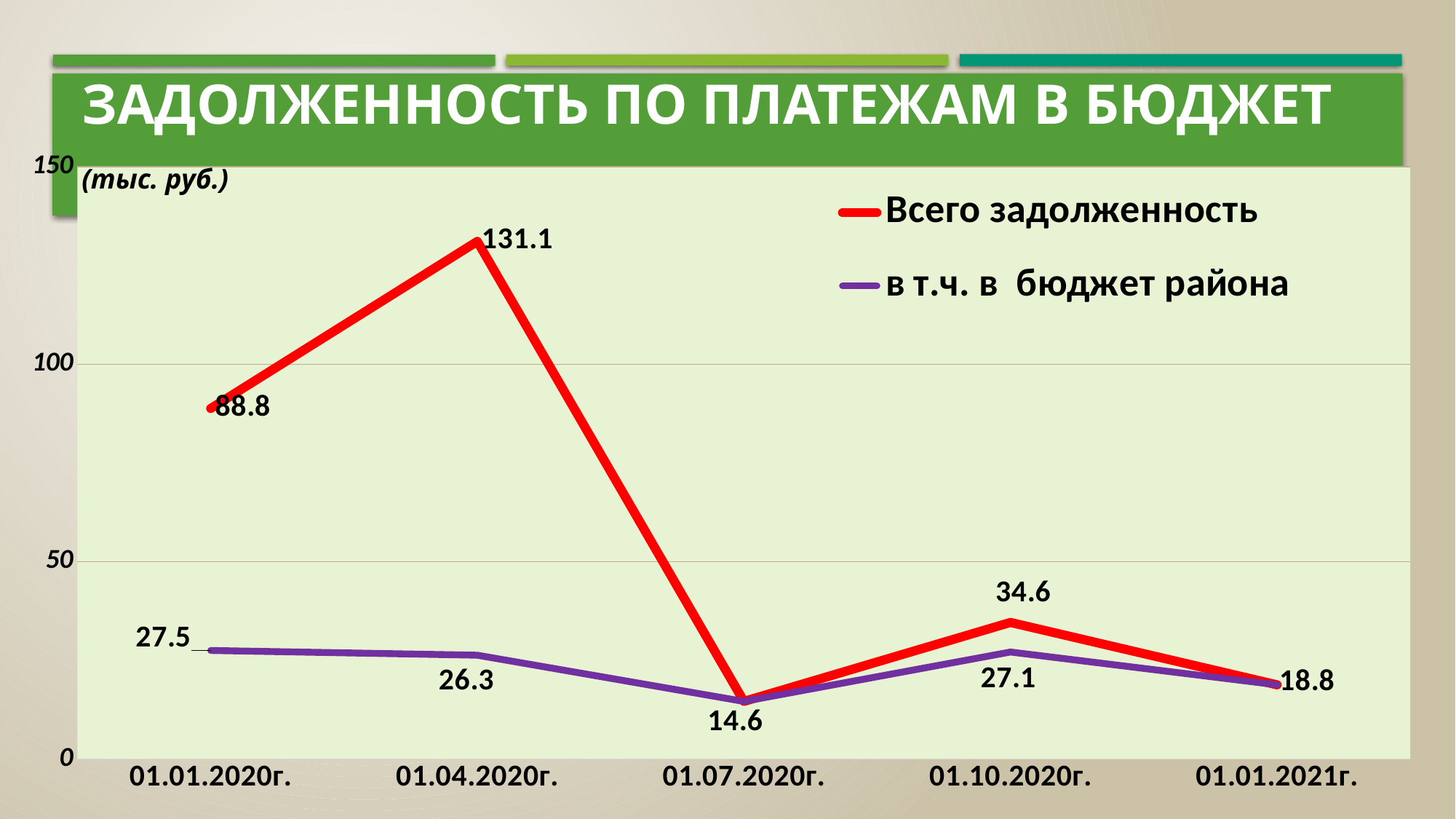
What is the value of «в т.ч. в бюджет района» on 01.10.2020г.? 27.1 How many series does the legend list? 2 What is the value of «Всего задолженность» on 01.10.2020г.? 34.6 What is the difference between «Всего задолженность» and «в т.ч. в бюджет района» on 01.10.2020г.? 7.5 What kind of chart is shown on the slide? line chart What is the value of «в т.ч. в бюджет района» on 01.04.2020г.? 26.3 What is the value of «Всего задолженность» on 01.04.2020г.? 131.1 How many dates are shown on the x axis? 5 Is the value of «Всего задолженность» on 01.04.2020г. greater or less than 100? greater What is the value of «Всего задолженность» on 01.01.2020г.? 88.8 On which date does «Всего задолженность» reach its highest value? 01.04.2020г. What is the value of «в т.ч. в бюджет района» on 01.01.2020г.? 27.5